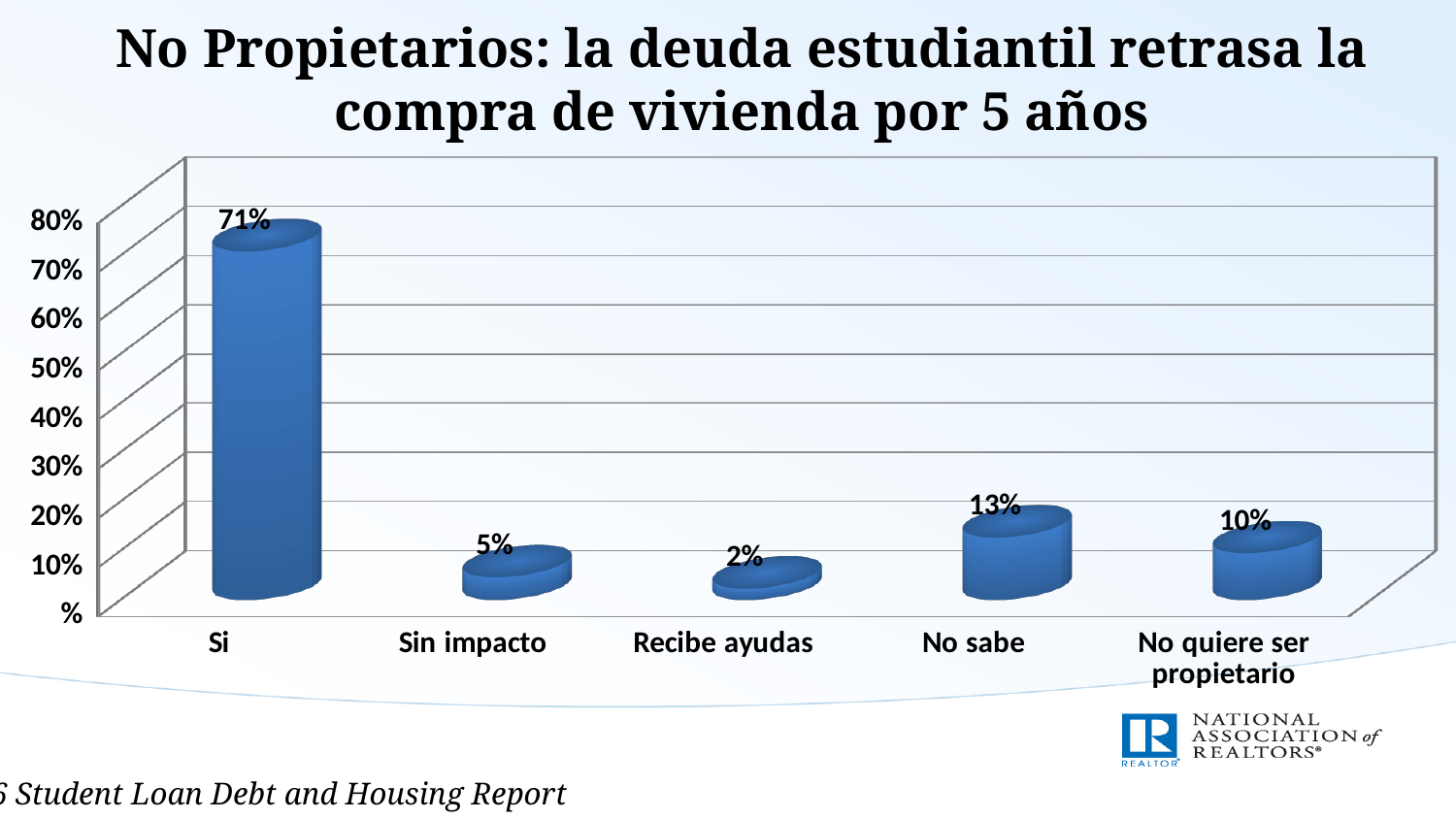
What is the title of the chart? No Propietarios: la deuda estudiantil retrasa la compra de vivienda por 5 años What is the value for "Si"? 71% What is the value for "No sabe"? 13% What is the value for "Recibe ayudas"? 2% Which is larger, the value for "No sabe" or the value for "No quiere ser propietario"? No sabe What is the difference between the values for "Si" and "No sabe"? 58% Which category has the highest value? Si What is the value for "Sin impacto"? 5% What is the value for "No quiere ser propietario"? 10% Which category has the lowest value? Recibe ayudas How many categories are shown on the chart? 5 What kind of chart is shown on the slide? Bar chart